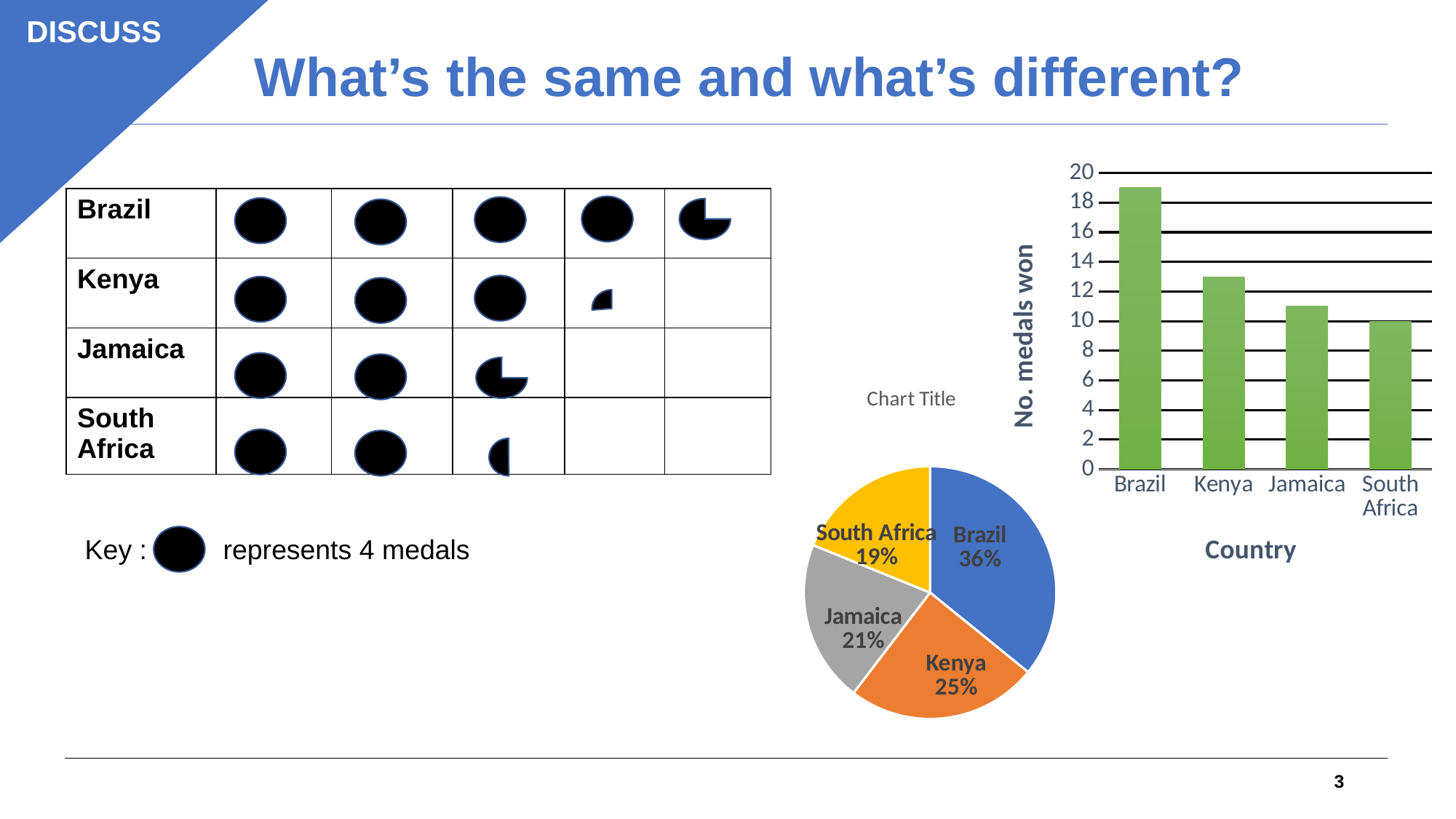
In the bar chart on the right, what is the label on the vertical axis? No. medals won In the pie chart, which country has the largest slice? Brazil In the pie chart, what percentage share does Kenya have? 25% In the bar chart on the right, which country has the tallest bar? Brazil In the bar chart on the right, is the value for Jamaica greater or less than 12? less In the bar chart on the right, which country has the shortest bar? South Africa In the pie chart, how many slices are there? 4 In the pie chart, what percentage share does Brazil have? 36% In the pie chart, what is the difference in percentage points between Brazil's share and Jamaica's share? 15 In the pie chart, which country has the smallest slice? South Africa In the bar chart on the right, is the value for Brazil greater or less than 16? greater In the pie chart, what percentage share does South Africa have? 19%